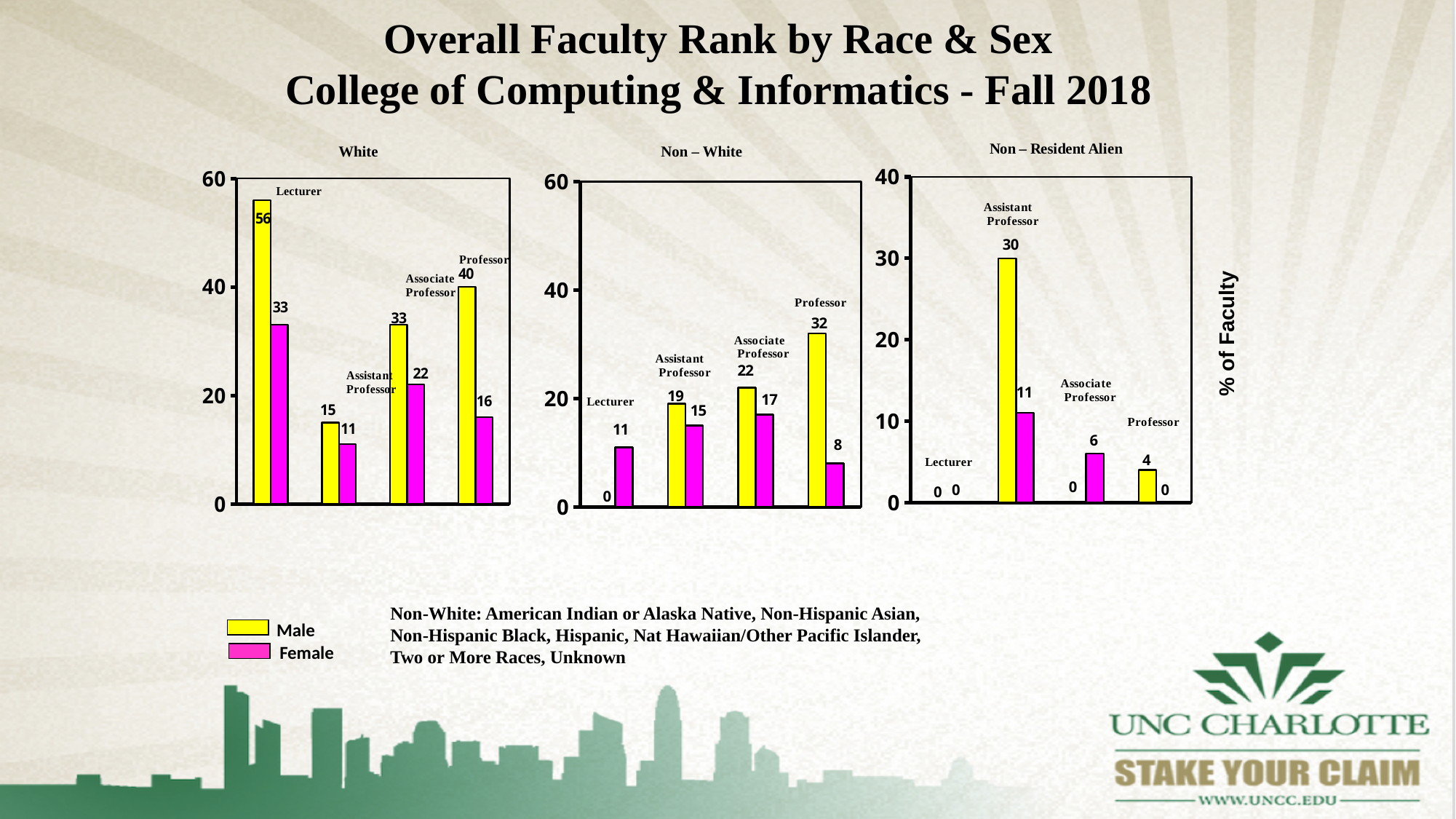
In the Non – White chart, which is larger for Assistant Professor, the Male value or the Female value? Male In the Non – White chart, which rank has the lowest Female value? Professor In the Non – Resident Alien chart, what is the value for Female Assistant Professor? 11 In the White chart, what is the value for Male Lecturer? 56 In the Non – White chart, what is the value for Male Professor? 32 In the White chart, what is the difference between the Male and Female values for Professor? 24 In the White chart, which rank has the highest Male value? Lecturer What kind of chart is the Non – White chart? Bar chart In the Non – Resident Alien chart, what is the value for Male Lecturer? 0 In the Non – Resident Alien chart, what is the difference between the Male and Female values for Assistant Professor? 19 In the White chart, what is the value for Female Professor? 16 How many series does the legend list? 2